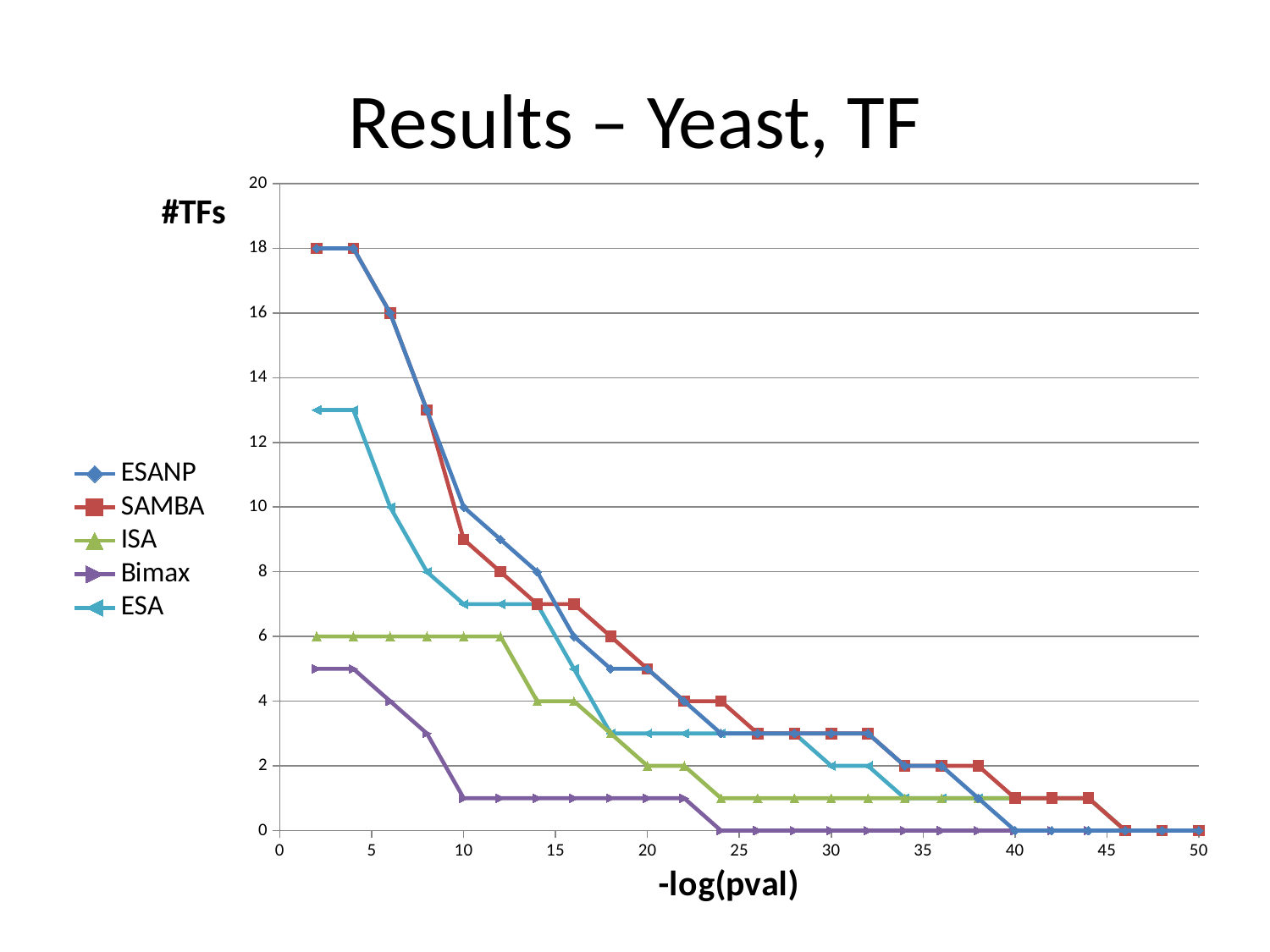
What is the difference between the SAMBA and ISA values at -log(pval) = 2? 12 At -log(pval) = 2, which series has the larger value, SAMBA or ISA? SAMBA What is the #TFs value for SAMBA at -log(pval) = 2? 18 How many series does the legend list? 5 Which series has the lowest value at -log(pval) = 2? Bimax Do the #TFs values rise or fall as -log(pval) increases? fall Is the value for Bimax at -log(pval) = 2 greater or less than 6? less Is the value for ESA at -log(pval) = 2 greater or less than 12? greater What is the #TFs value for ESANP at -log(pval) = 10? 10 What is the #TFs value for ISA at -log(pval) = 2? 6 What is the #TFs value for Bimax at -log(pval) = 30? 0 What kind of chart is shown on the slide? line chart